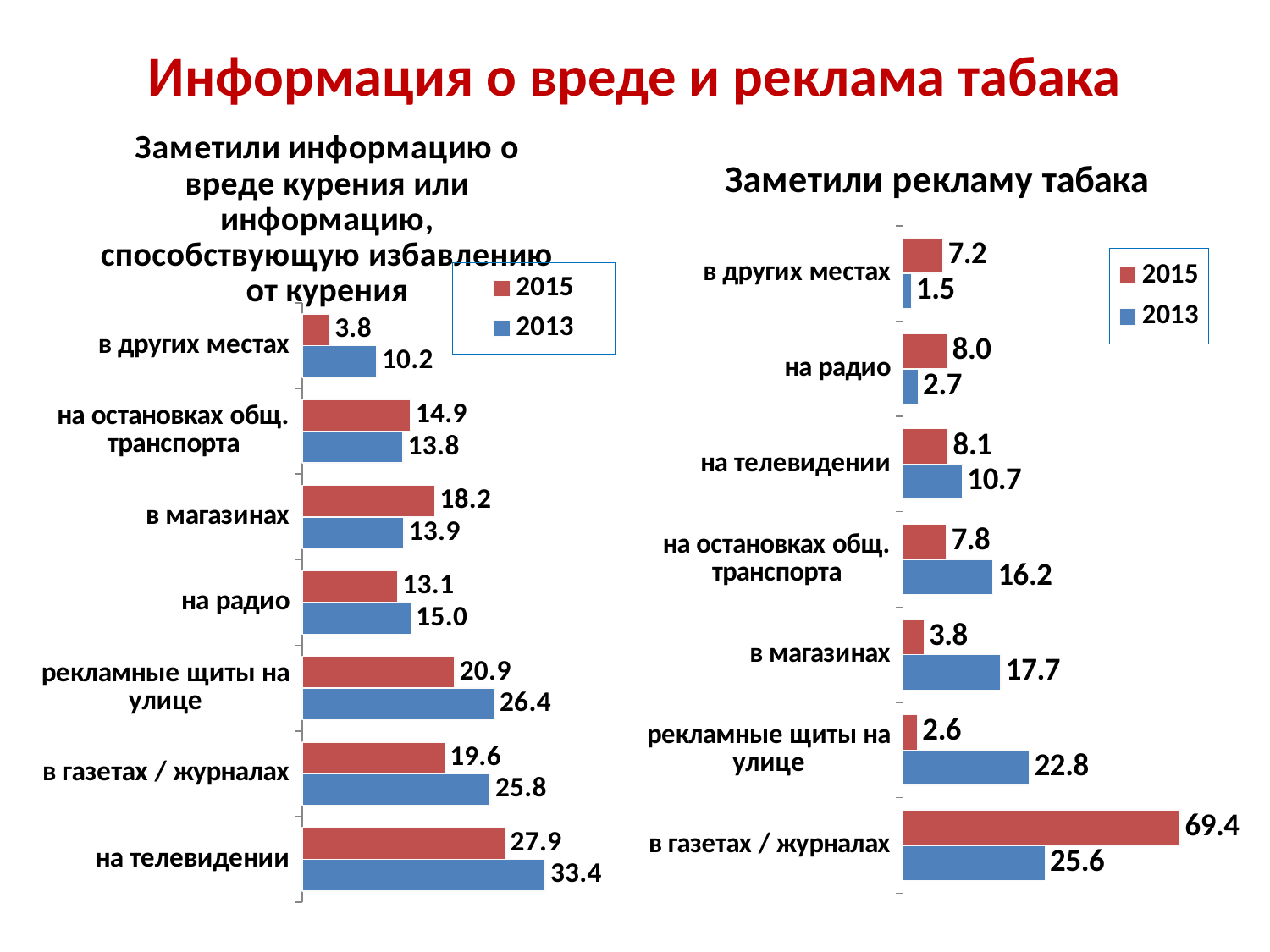
What type of chart is the right chart ("Заметили рекламу табака")? bar chart How many categories does the right chart ("Заметили рекламу табака") show? 7 How many series does the legend of the left chart list? 2 In the right chart, what is the difference between the 2015 and 2013 values for "в газетах / журналах"? 43.8 In the left chart, what is the difference between the 2013 and 2015 values for "в других местах"? 6.4 In the left chart, what is the 2013 value for "рекламные щиты на улице"? 26.4 In the right chart ("Заметили рекламу табака"), what is the 2015 value for "в газетах / журналах"? 69.4 In the right chart, what is the 2013 value for "в магазинах"? 17.7 In the left chart, which is larger for "в магазинах": the 2015 value or the 2013 value? 2015 In the left chart ("Заметили информацию о вреде курения..."), what is the 2015 value for "на телевидении"? 27.9 In the right chart, which category has the lowest 2013 value? в других местах In the left chart, which category has the highest 2013 value? на телевидении